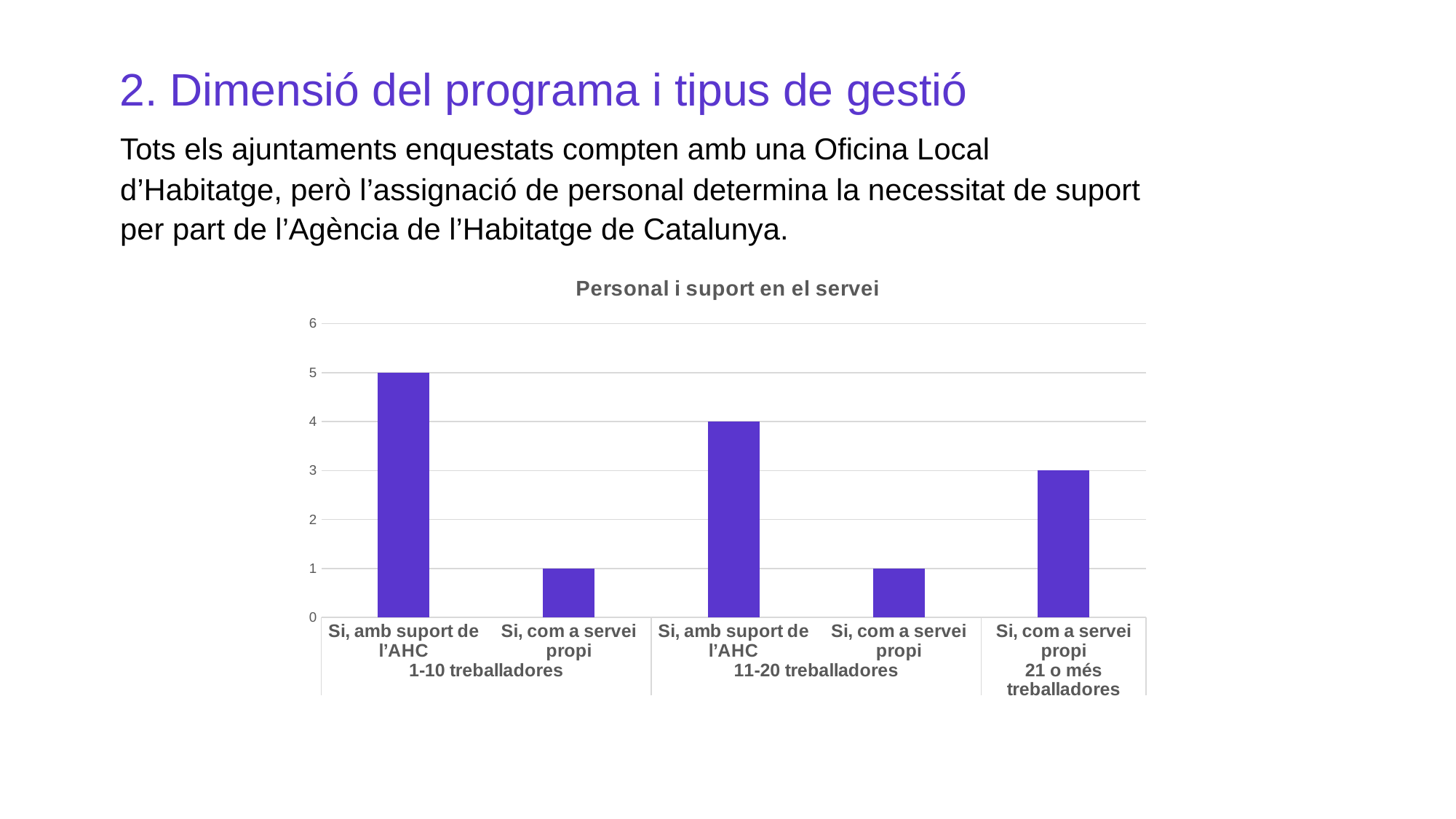
What is the value for 'Si, amb suport de l'AHC' in the '11-20 treballadores' group? 4 What is the value for 'Si, com a servei propi' in the '11-20 treballadores' group? 1 Which bar has the highest value in the chart? Si, amb suport de l'AHC (1-10 treballadores) Which is larger: 'Si, amb suport de l'AHC' for 11-20 treballadores or 'Si, com a servei propi' for 21 o més treballadores? Si, amb suport de l'AHC for 11-20 treballadores What kind of chart is shown on the slide? bar chart What is the value for 'Si, amb suport de l'AHC' in the '1-10 treballadores' group? 5 How many worker-size groups are shown on the x axis? 3 Is the value for 'Si, amb suport de l'AHC' in the '11-20 treballadores' group greater or less than 2? greater What is the difference between 'Si, amb suport de l'AHC' and 'Si, com a servei propi' in the '1-10 treballadores' group? 4 What is the title of the chart? Personal i suport en el servei What is the value for 'Si, com a servei propi' in the '21 o més treballadores' group? 3 How many bars are plotted in the chart? 5